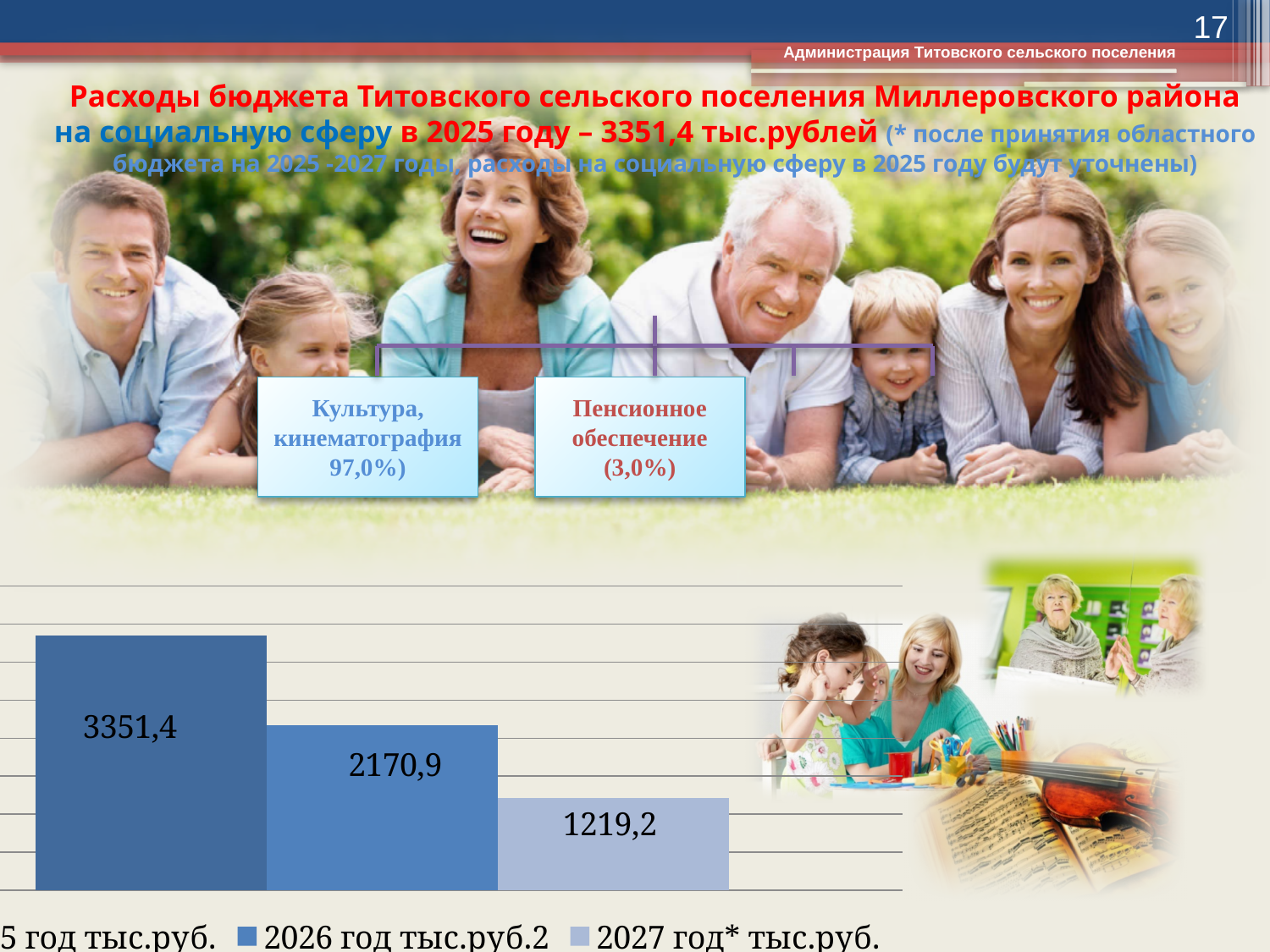
Do the bar values rise or fall from left to right across the chart? fall How many series does the chart legend list? 3 What is the value for 2026 год тыс.руб.? 2170,9 What type of chart is shown at the bottom of the slide? bar chart What is the difference between the 2025 value (3351,4) and the 2026 value? 1180,5 What is the difference between the 2026 value and the 2027 value? 951,7 How many bars are plotted in the chart? 3 What is the value for 2027 год* тыс.руб.? 1219,2 Which bar has the highest value? 2025 год тыс.руб. (leftmost bar) Which is larger, the value for 2026 год тыс.руб. or for 2027 год* тыс.руб.? 2026 год тыс.руб. Which bar has the lowest value? 2027 год* тыс.руб. What is the value of the leftmost bar (2025 год тыс.руб.)? 3351,4